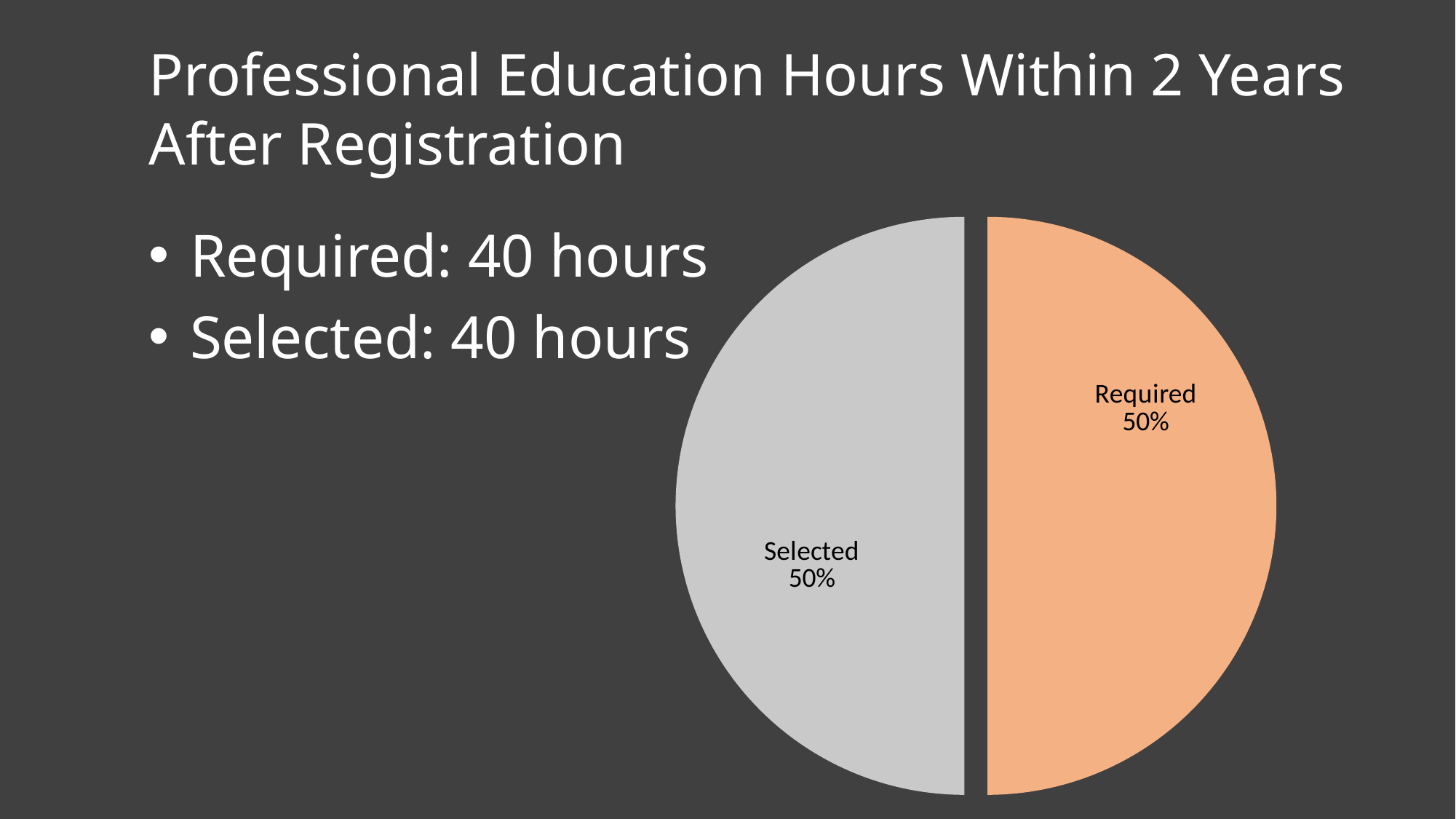
What is the difference between the Required and Selected percentages in the pie chart? 0% What are the names of the two slices in the pie chart? Required and Selected What is the percentage label shown on the Selected slice? 50% What colour is the Selected slice of the pie chart? grey What share of the pie does the Selected slice represent? 50% What share of the pie does the Required slice represent? 50% What colour is the Required slice of the pie chart? orange What is the percentage label shown on the Required slice? 50% How many slices does the pie chart have? 2 What kind of chart is shown on the slide? pie chart